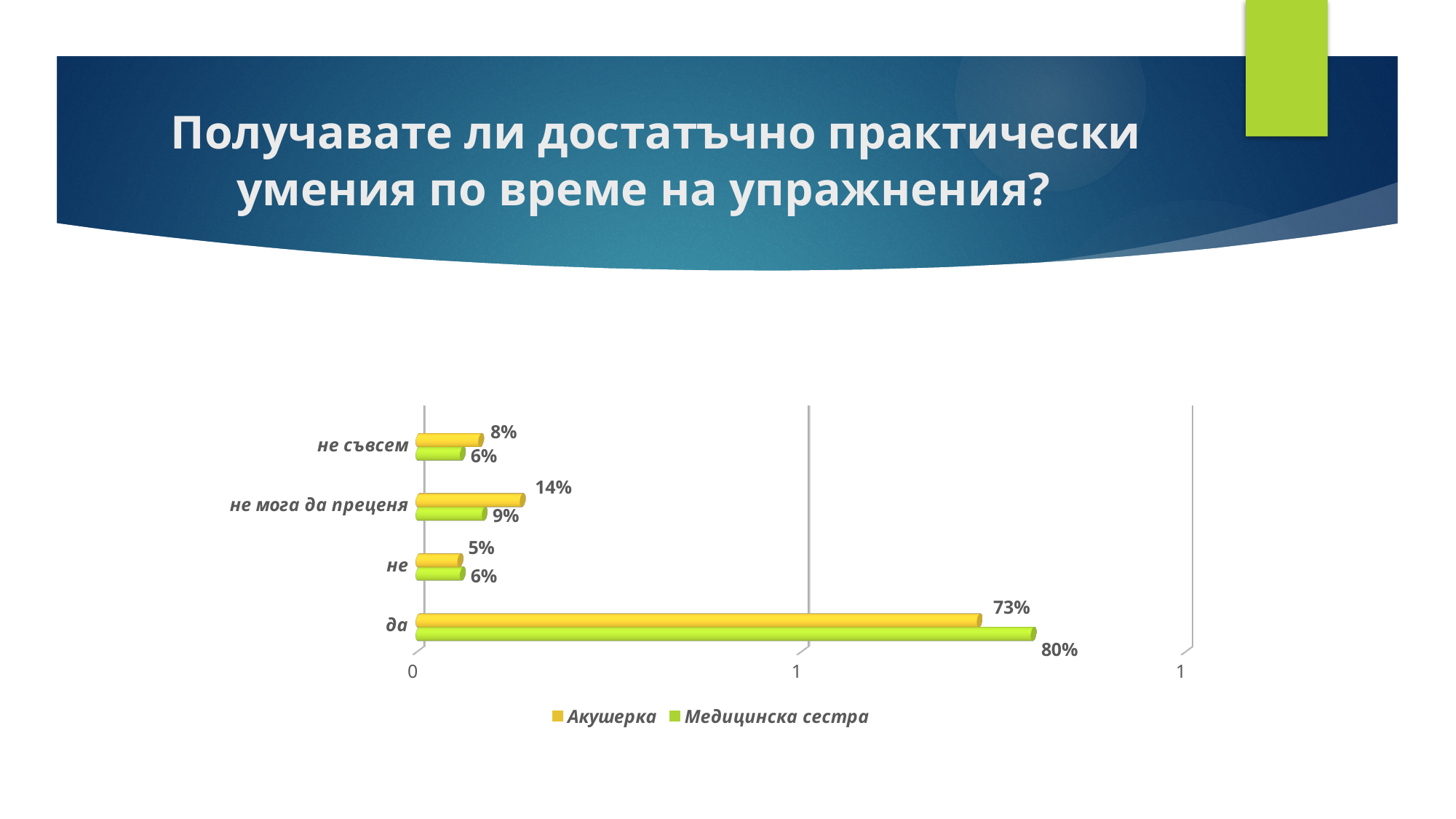
How many categories are shown on the chart? 4 In the category "не мога да преценя", which series has the larger value, Акушерка or Медицинска сестра? Акушерка How many series does the legend list? 2 What value is shown for Медицинска сестра in the category "не съвсем"? 6% What value is shown for Медицинска сестра in the category "да"? 80% What is the difference between the Медицинска сестра and Акушерка values in the category "да"? 7% Which category has the highest value for Медицинска сестра? да Which colour represents the Медицинска сестра series? Green Which category has the lowest value for Акушерка? не What type of chart is shown on the slide? Bar chart What value is shown for Акушерка in the category "не мога да преценя"? 14% What value is shown for Акушерка in the category "да"? 73%